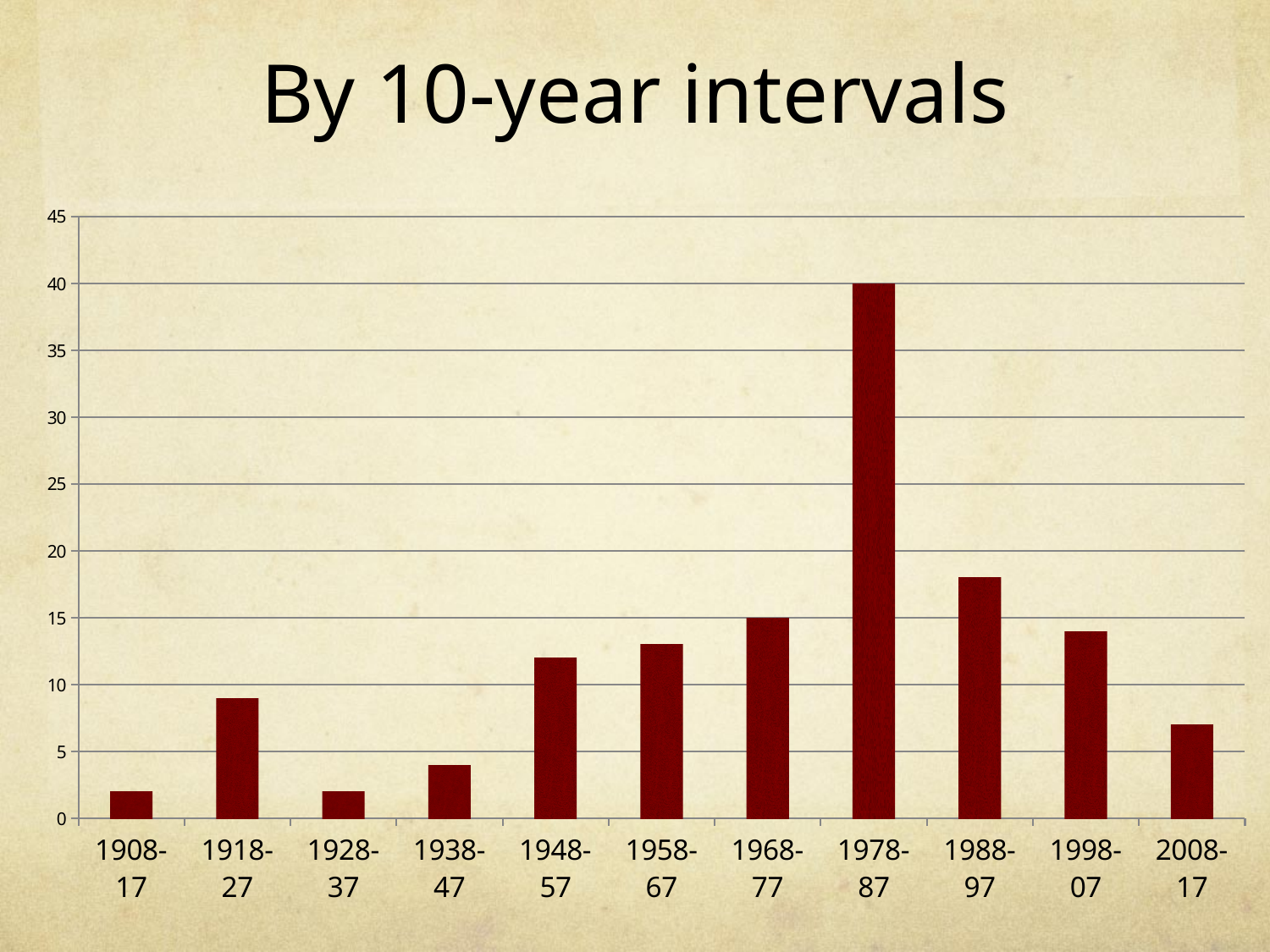
What is the value for 1968-77? 15 Which interval has the highest value? 1978-87 Is the value for 1988-97 greater or less than 15? greater How many 10-year intervals are shown on the x axis? 11 What is the difference between the values for 1978-87 and 1968-77? 25 What is the title of the chart? By 10-year intervals Is the value for 1938-47 greater or less than 5? less Which is larger, the value for 1988-97 or the value for 1998-07? 1988-97 What is the value for 1978-87? 40 What kind of chart is shown on the slide? bar chart Is the value for 2008-17 greater or less than 5? greater